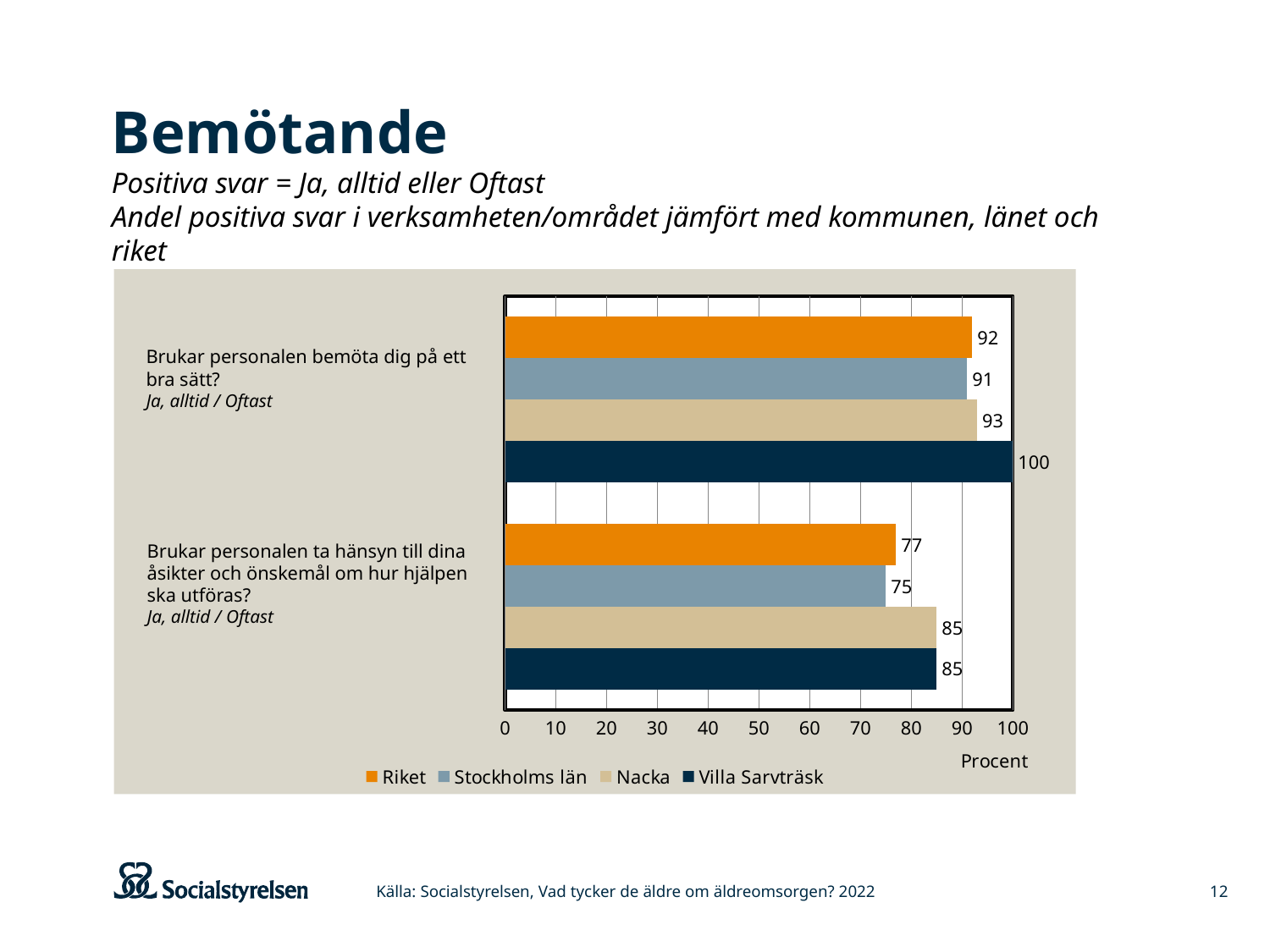
What is the difference between the Villa Sarvträsk value and the Riket value on the question "Brukar personalen bemöta dig på ett bra sätt?"? 8 What is the label of the x axis? Procent What is the difference between the Nacka value and the Stockholms län value on the question "Brukar personalen ta hänsyn till dina åsikter och önskemål om hur hjälpen ska utföras?"? 10 What is the value for Riket on the question "Brukar personalen ta hänsyn till dina åsikter och önskemål om hur hjälpen ska utföras?"? 77 What is the value for Villa Sarvträsk on the question "Brukar personalen bemöta dig på ett bra sätt?"? 100 Which series has the highest value on the question "Brukar personalen bemöta dig på ett bra sätt?"? Villa Sarvträsk What kind of chart is shown on the slide? Bar chart What is the value for Nacka on the question "Brukar personalen bemöta dig på ett bra sätt?"? 93 Which series has the lowest value on the question "Brukar personalen ta hänsyn till dina åsikter och önskemål om hur hjälpen ska utföras?"? Stockholms län What is the value for Stockholms län on the question "Brukar personalen ta hänsyn till dina åsikter och önskemål om hur hjälpen ska utföras?"? 75 Which is larger on the question "Brukar personalen bemöta dig på ett bra sätt?": the value for Riket or the value for Stockholms län? Riket How many series does the legend list? 4